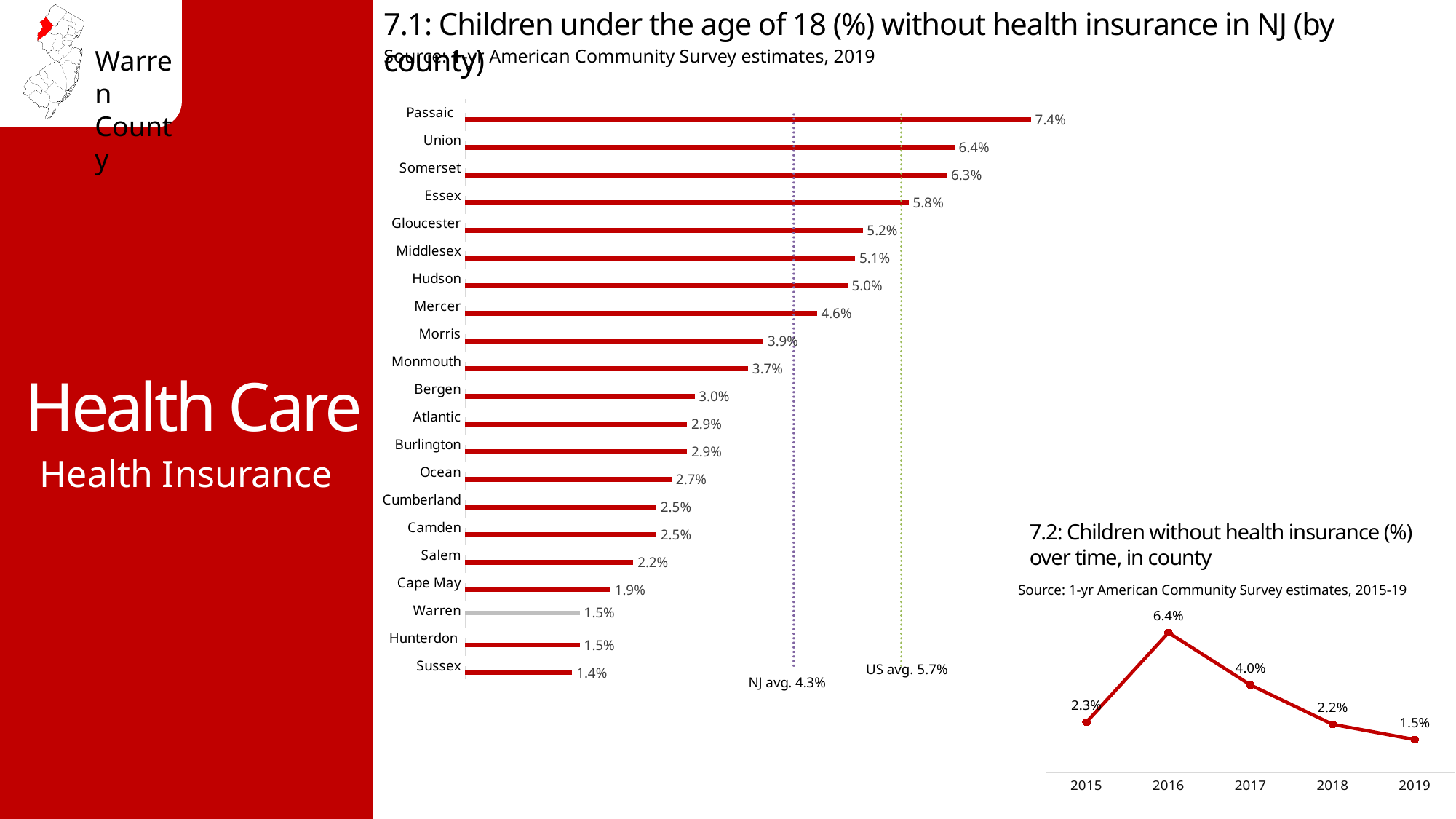
In chart 7.1, which county has the highest value? Passaic In chart 7.2, what is the difference between 2016 and 2019? 4.9% In chart 7.2, what is the value for 2016? 6.4% In chart 7.1, what is the value for Warren? 1.5% In chart 7.1, how many counties are shown? 21 In chart 7.2, do the values rise or fall from 2016 to 2019? Fall In chart 7.1, which county has the lowest value? Sussex In chart 7.1, what is the difference between Passaic and Sussex? 6.0% What kind of chart is chart 7.1? Bar chart In chart 7.1, what is the value for Passaic? 7.4% In chart 7.1, what is the NJ average shown by the dotted line? 4.3% In chart 7.1, which is larger, the value for Mercer or the value for Morris? Mercer